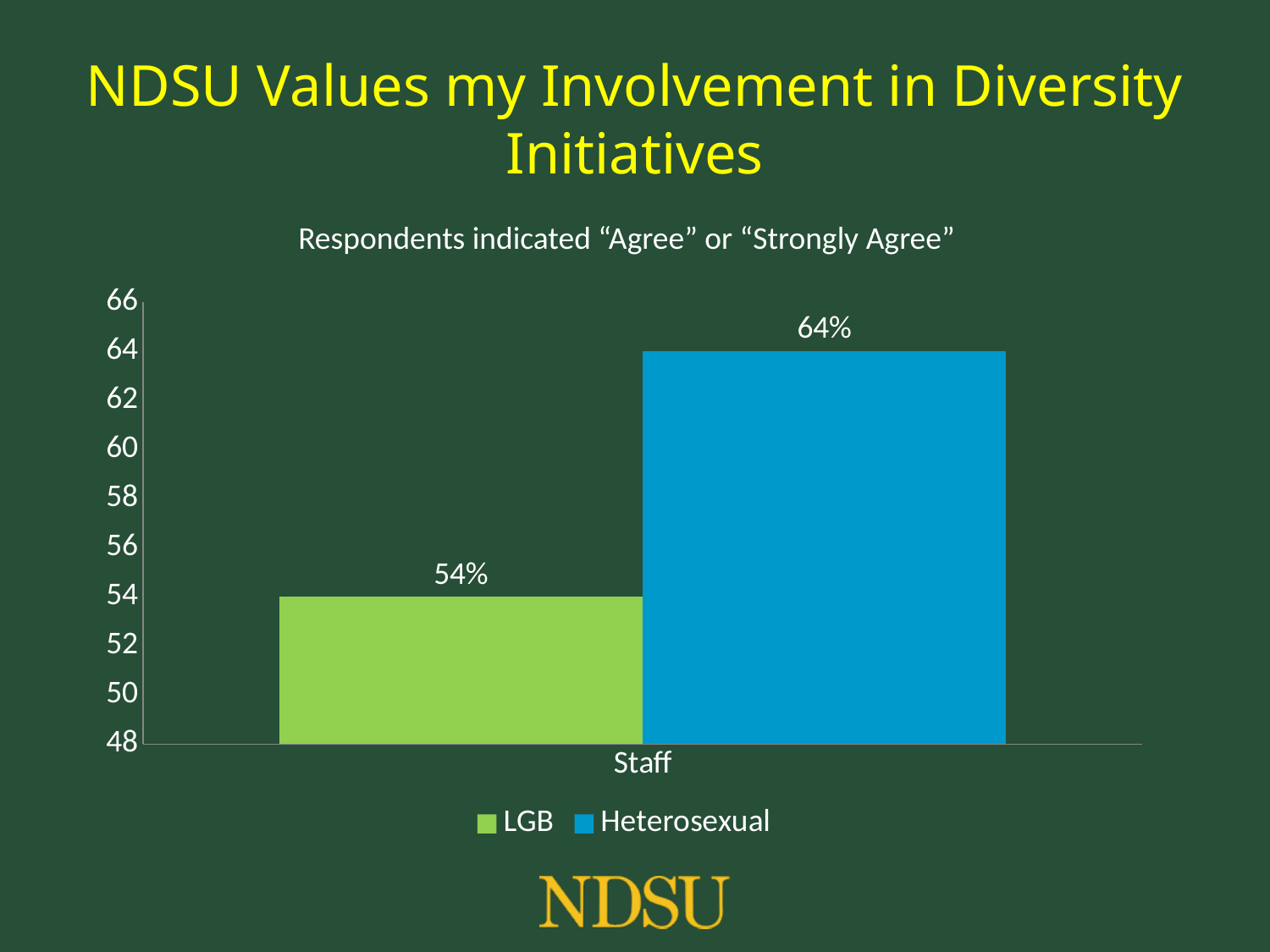
What kind of chart is shown on the slide? bar chart How many categories are shown on the x axis? 1 Which series has the higher value for Staff, LGB or Heterosexual? Heterosexual What colour is the bar for the Heterosexual series? blue Which series has the lowest value on the chart? LGB Is the value for Heterosexual greater or less than 60? greater What is the title of the chart? Respondents indicated "Agree" or "Strongly Agree" Is the value for LGB greater or less than 56? less What is the difference between the Heterosexual and LGB values for Staff? 10% What percentage of Heterosexual staff indicated "Agree" or "Strongly Agree"? 64% How many series does the legend list? 2 What percentage of LGB staff indicated "Agree" or "Strongly Agree"? 54%